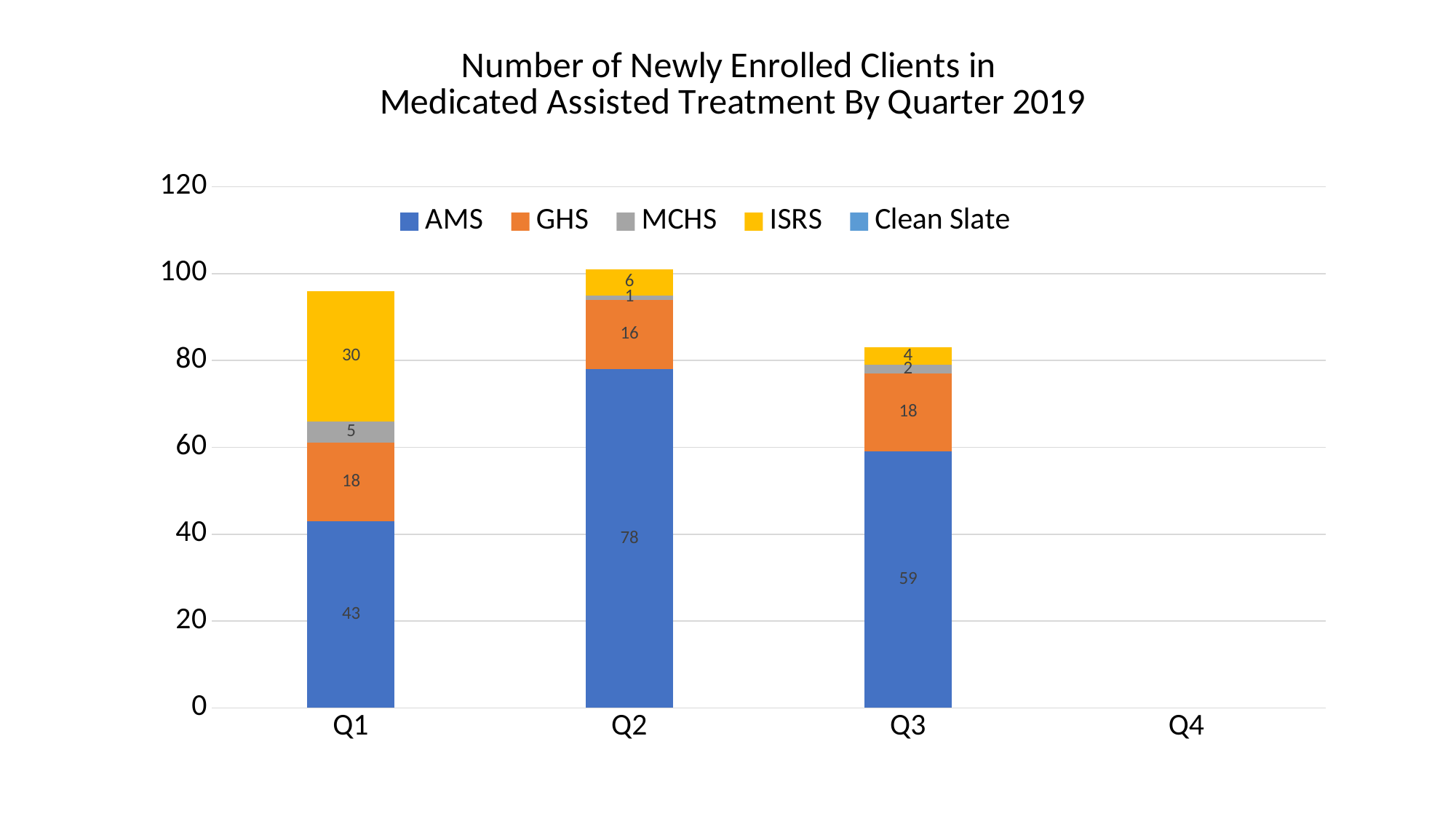
Is the total height of the Q2 bar greater or less than 100? greater What is the AMS value for Q2? 78 What is the MCHS value for Q2? 1 What kind of chart is shown on the slide? stacked bar chart In which quarter is the ISRS value lowest among Q1, Q2 and Q3? Q3 What is the total of the Q1 stacked bar? 96 What is the GHS value for Q3? 18 How many series does the legend list? 5 What is the ISRS value for Q1? 30 In which quarter is the AMS value highest? Q2 What is the difference between the AMS values for Q2 and Q1? 35 Which is larger, the ISRS value for Q1 or the ISRS value for Q2? Q1